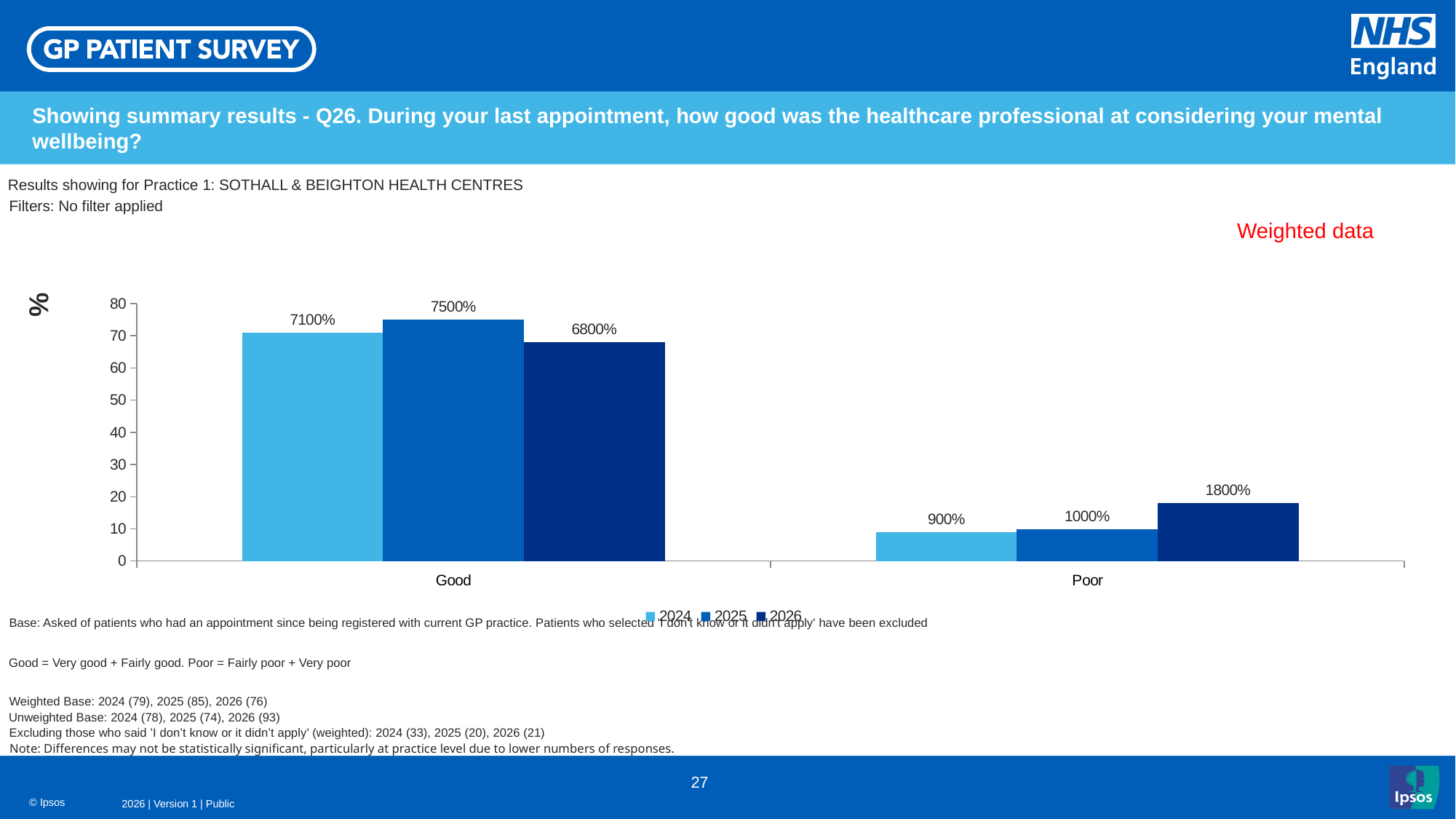
Which is larger in the Good category, the 2024 value or the 2026 value? 2024 What is the difference between the 2025 and 2026 values in the Good category? 700% How many series does the legend list? 3 Is the value for 2026 in the Poor category greater or less than 20? less What label is shown on the vertical axis of the chart? % Which year has the lowest value in the Poor category? 2024 Which year has the highest value in the Good category? 2025 What is the value for 2026 in the Poor category? 1800% What is the value for 2024 in the Good category? 7100% How many categories are shown on the x axis? 2 What kind of chart is shown on the slide? bar chart What is the value for 2025 in the Poor category? 1000%